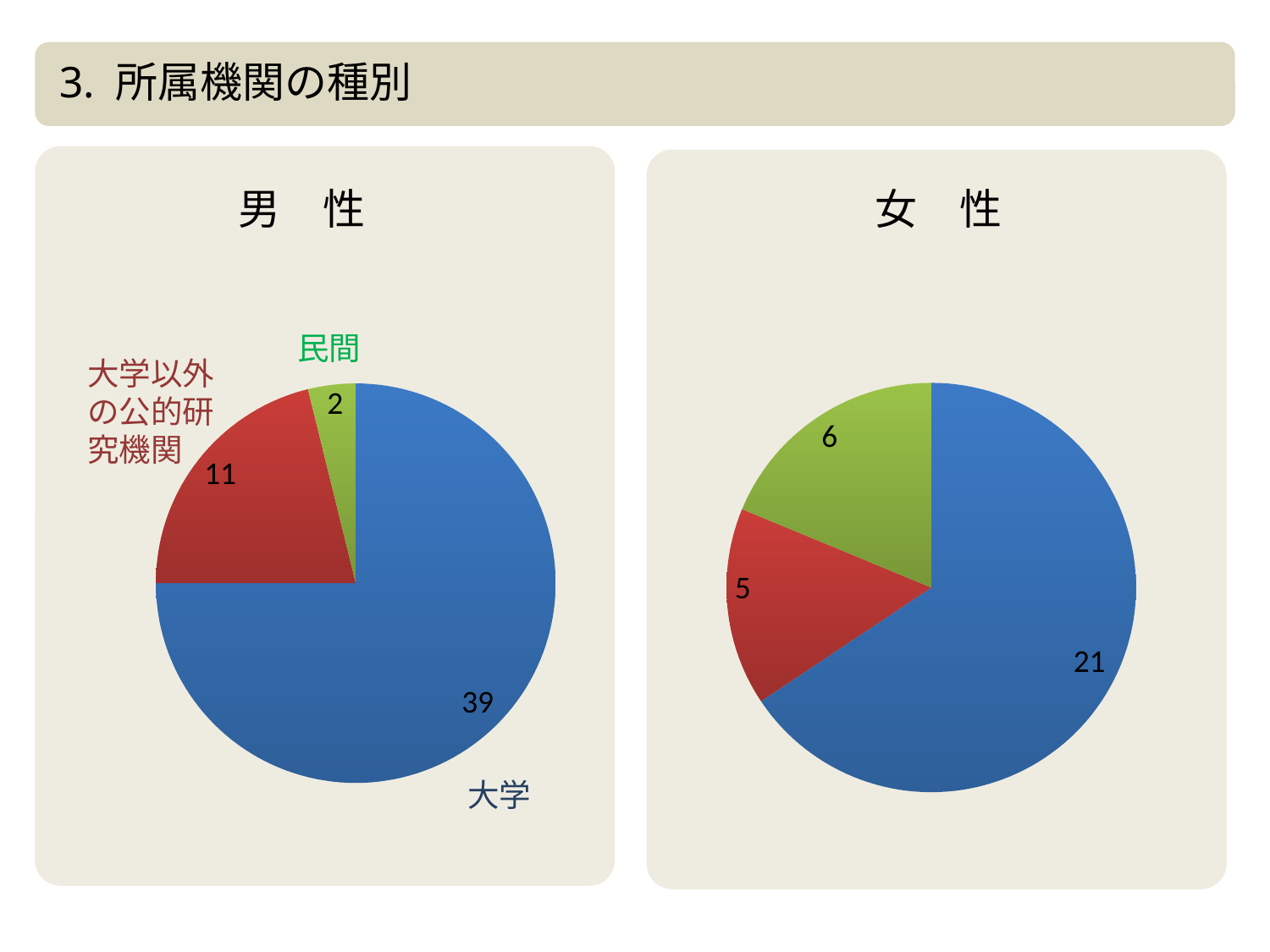
What type of chart is used on this slide? pie chart In the 男性 chart, what is the value for 民間? 2 In the 男性 chart, what is the difference between the values for 大学 and 大学以外の公的研究機関? 28 In the 男性 chart, what is the value for 大学以外の公的研究機関? 11 How many slices does the 女性 chart have? 3 In the 男性 chart, what is the value for 大学? 39 In the 男性 chart, which category has the smallest slice? 民間 In the 男性 chart, what share of the total does 大学 represent? 75% In the 女性 chart, what is the value of the blue slice? 21 In the 女性 chart, which is larger, the green slice or the red slice? the green slice In the 女性 chart, what is the value of the red slice? 5 In the 男性 chart, which category has the largest slice? 大学